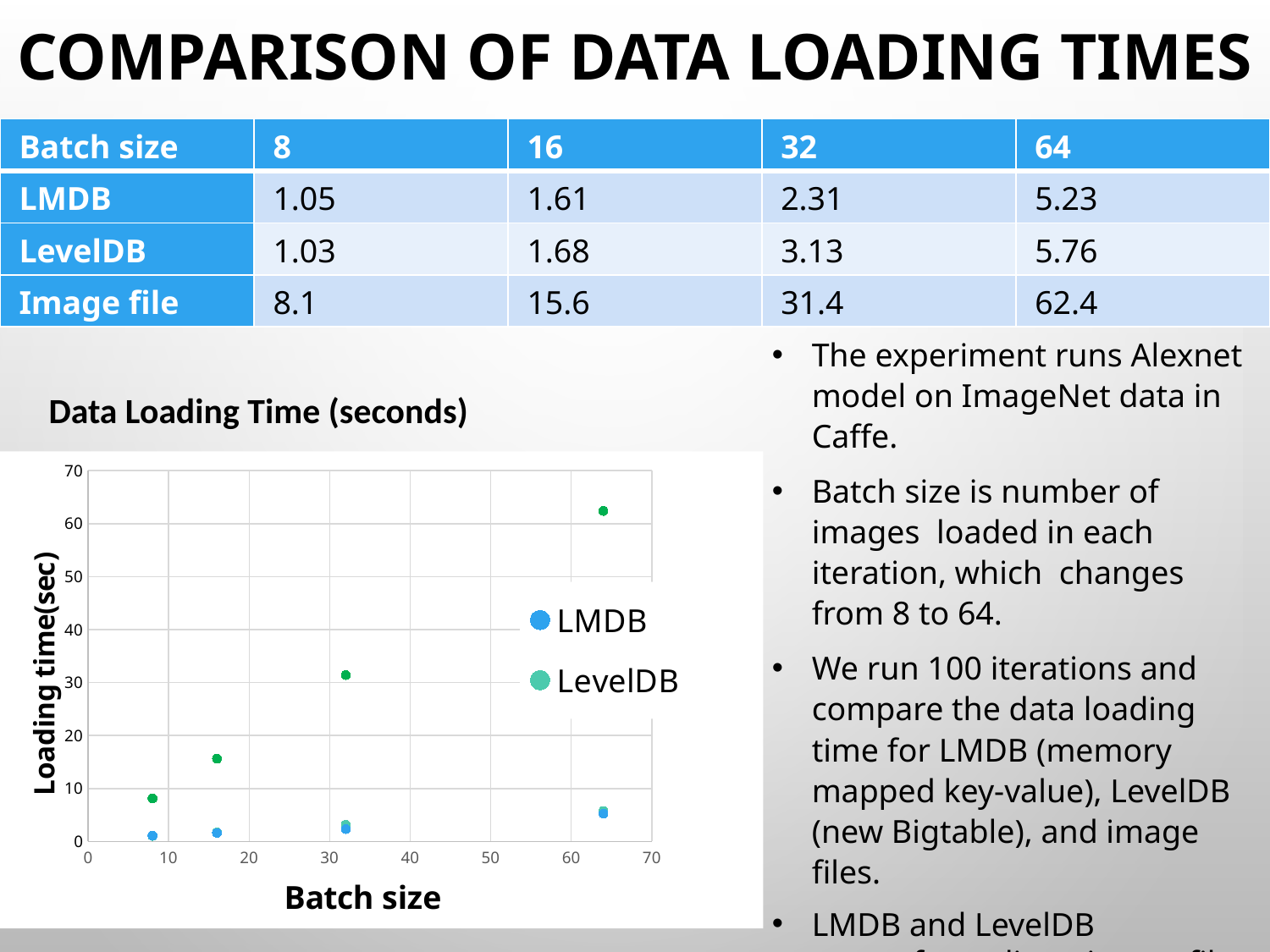
According to the table, which data source has the highest loading time at batch size 16? Image file What is the label of the chart's y axis? Loading time(sec) How many batch sizes are plotted along the x axis of the chart? 4 Does the loading time rise or fall as batch size increases from 8 to 64? rise Is the loading time of the highest point at batch size 64 greater or less than 60 seconds? greater What kind of chart is shown on the slide? scatter chart According to the table, what is the LMDB loading time at batch size 32? 2.31 Is the LMDB loading time at batch size 64 greater or less than 10 seconds? less How many series does the chart's legend list? 2 What is the title of the chart? Data Loading Time (seconds) According to the table, what is the Image file loading time at batch size 64? 62.4